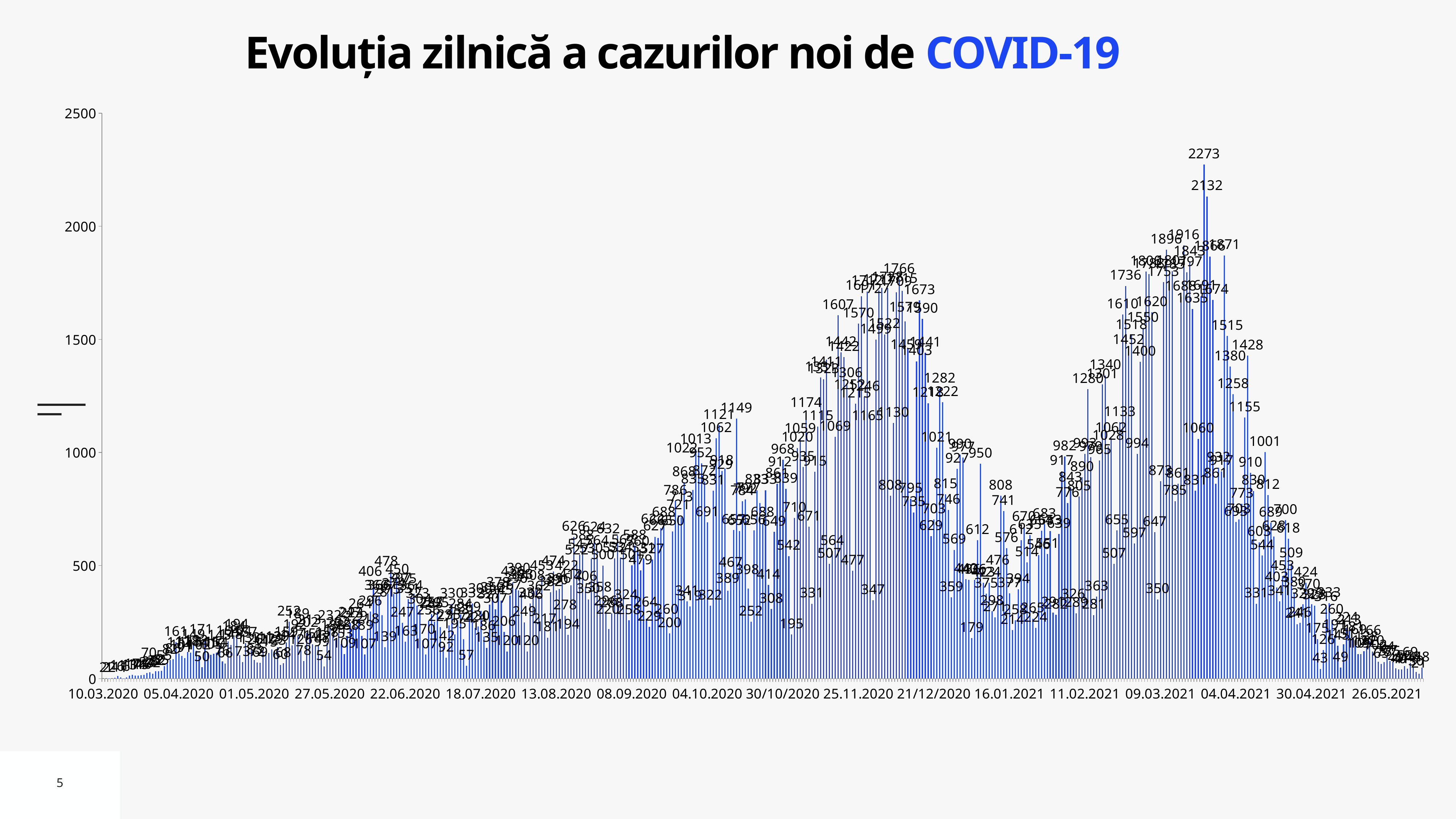
What is the highest labelled value in the peak around 25.11.2020? 1766 What is the difference between the peak value 2273 and the peak value 1766? 507 What is the difference between the two tallest labelled bars, 2273 and 2132? 141 What is the highest value shown on the vertical axis? 2500 Which peak is higher: the one around 04.04.2021 or the one around 25.11.2020? the one around 04.04.2021 How many date labels are shown along the x axis? 18 What is the highest daily value labelled on the chart? 2273 Is the highest bar on the chart greater or less than 2000? greater Is the value for the first bar at 10.03.2020 greater or less than 500? less What kind of chart is shown on the slide? bar chart What is the second-highest daily value labelled on the chart, next to the 2273 peak? 2132 What is the title of the chart? Evoluția zilnică a cazurilor noi de COVID-19